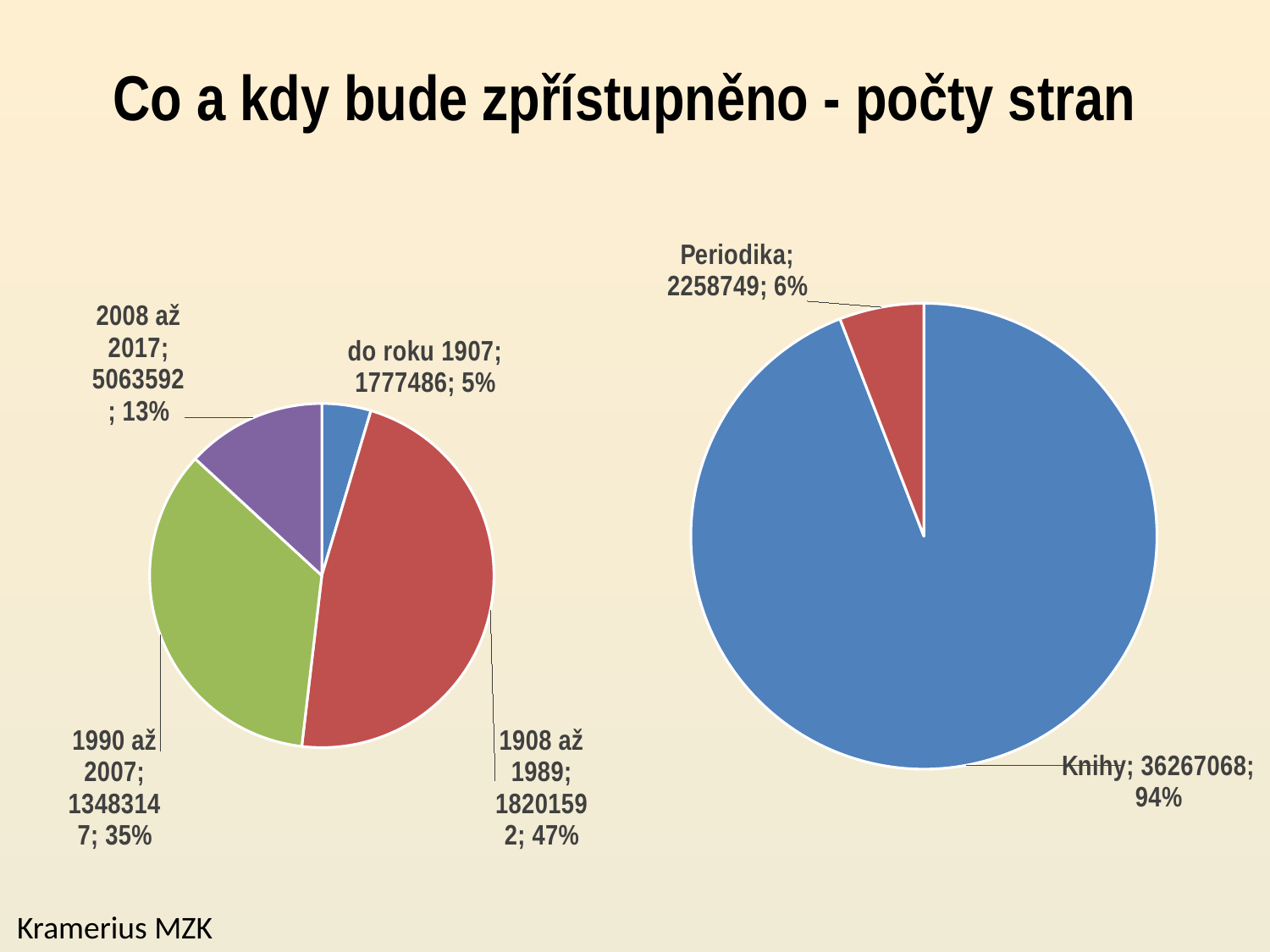
In the right pie chart, what value is shown for 'Periodika'? 2258749 How many slices does the left pie chart have? 4 In the left pie chart, what share of the pie does '1908 až 1989' take? 47% In the right pie chart, what is the difference between the values for 'Knihy' and 'Periodika'? 34008319 In the left pie chart, what value is shown for '2008 až 2017'? 5063592 In the right pie chart, what share of the pie does 'Knihy' take? 94% In the left pie chart, which category has the smallest slice? do roku 1907 In the left pie chart, which is larger: '1990 až 2007' or '2008 až 2017'? 1990 až 2007 What kind of chart is the chart on the left of the slide? pie chart In the left pie chart, which category has the largest slice? 1908 až 1989 How many slices does the right pie chart have? 2 In the left pie chart, what value is shown for 'do roku 1907'? 1777486